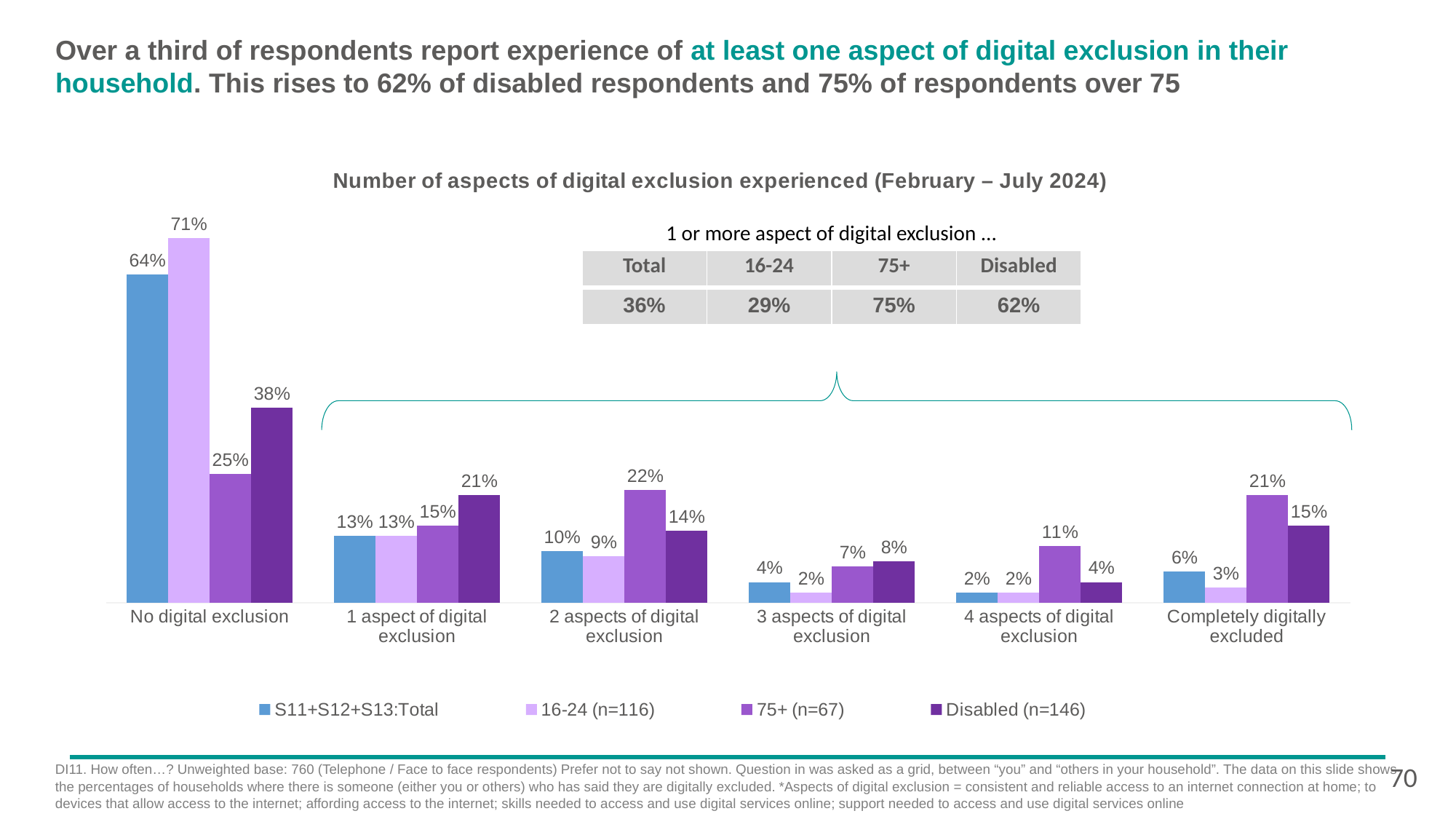
What is the title of the chart? Number of aspects of digital exclusion experienced (February – July 2024) What kind of chart is shown on the slide? Bar chart What is the difference between the 16-24 (n=116) and 75+ (n=67) values in the 'No digital exclusion' category? 46% In the '4 aspects of digital exclusion' category, which is larger: the 75+ (n=67) value or the Disabled (n=146) value? 75+ (n=67) What is the value for the Disabled (n=146) series in the 'Completely digitally excluded' category? 15% Which category has the highest value for the S11+S12+S13:Total series? No digital exclusion How many series does the legend list? 4 According to the table on the chart, what percentage of 75+ respondents report 1 or more aspect of digital exclusion? 75% What is the value for the 75+ (n=67) series in the '2 aspects of digital exclusion' category? 22% Which category has the lowest value for the 16-24 (n=116) series? 3 aspects of digital exclusion and 4 aspects of digital exclusion (both 2%) How many categories are shown on the x axis? 6 What is the value for the 16-24 (n=116) series in the 'No digital exclusion' category? 71%